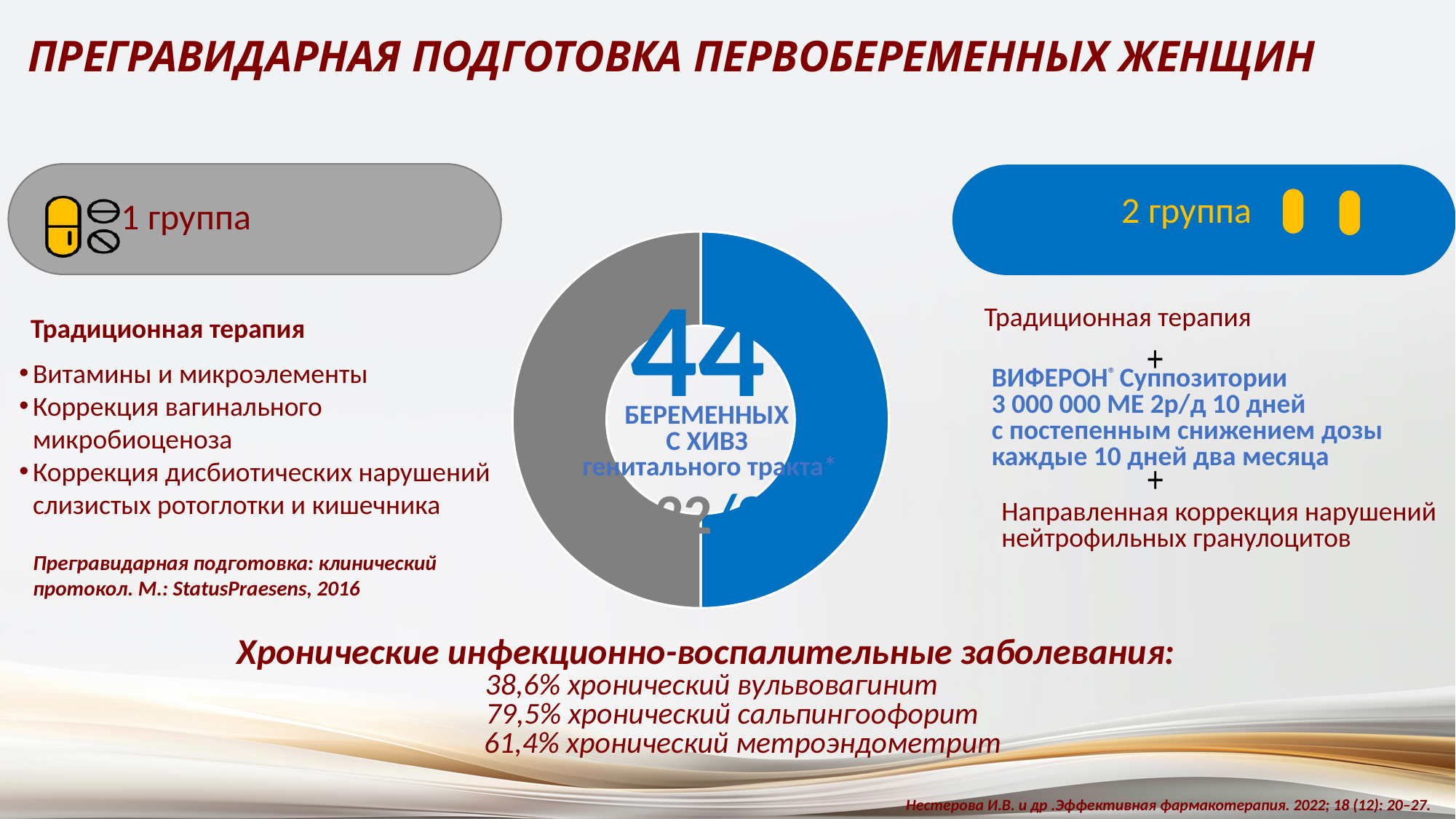
What kind of chart is shown in the centre of the slide? pie chart (donut) According to the text in the centre of the donut chart, what does the number 44 refer to? беременных с ХИВЗ генитального тракта What two colours are used for the segments of the donut chart? grey and blue How many segments does the donut chart in the centre of the slide have? 2 What number is printed in the centre of the donut chart? 44 Which colour is the right-hand segment of the donut chart? blue